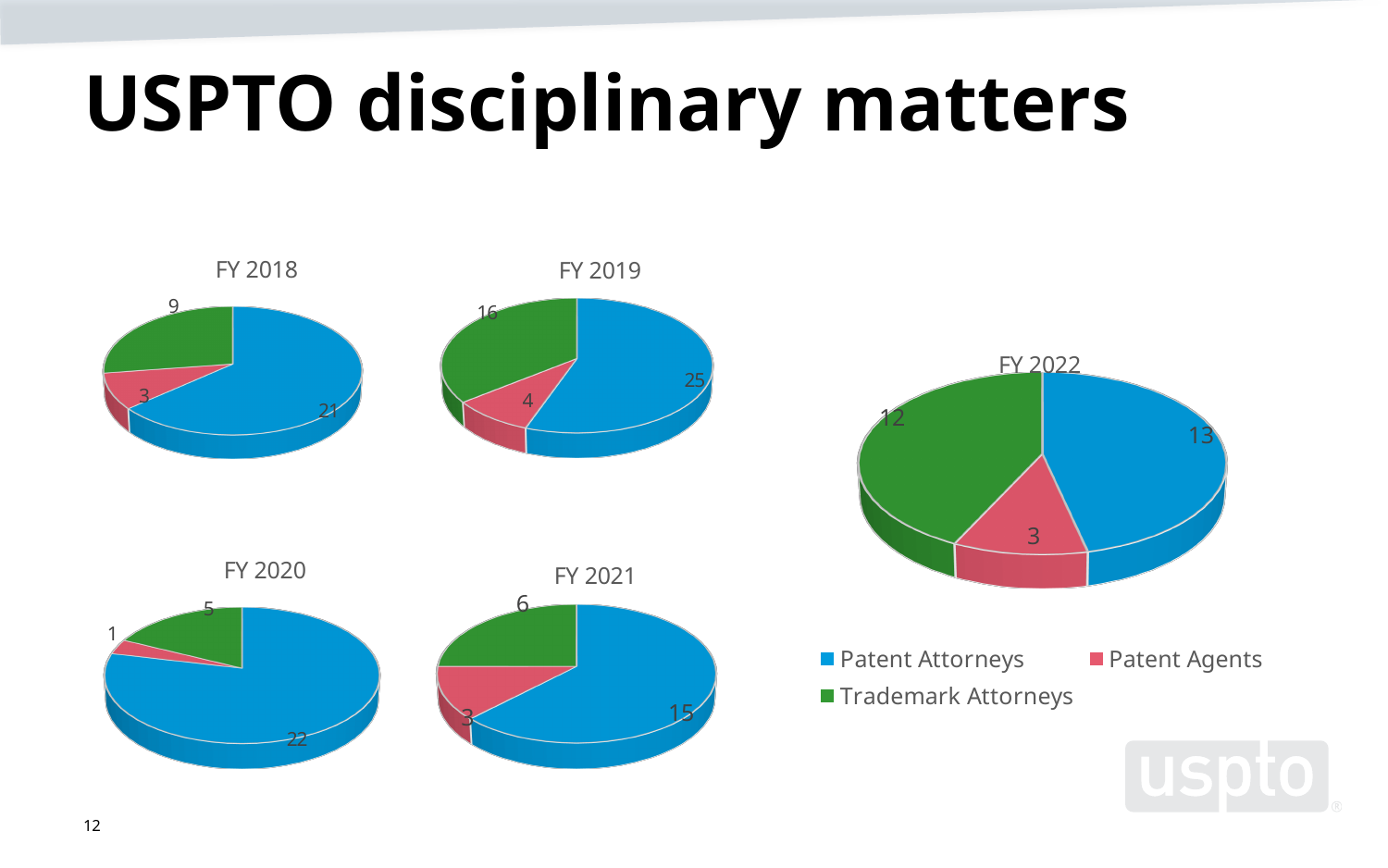
In the FY 2020 pie chart, what is the value for Patent Agents? 1 In the FY 2019 pie chart, which category has the smallest slice? Patent Agents In the FY 2020 pie chart, which is larger: Trademark Attorneys or Patent Agents? Trademark Attorneys In the FY 2018 pie chart, what is the value for Patent Attorneys? 21 How many pie charts are shown on the slide? 5 How many categories does the legend list? 3 What kind of chart is used for FY 2018? Pie chart In the FY 2021 pie chart, what share of the total do Patent Attorneys represent? 62.5% In the FY 2022 pie chart, what is the value for Trademark Attorneys? 12 In the FY 2019 pie chart, what is the value for Trademark Attorneys? 16 In the FY 2022 pie chart, what is the difference between the Patent Attorneys value and the Trademark Attorneys value? 1 In the FY 2021 pie chart, which category has the largest slice? Patent Attorneys